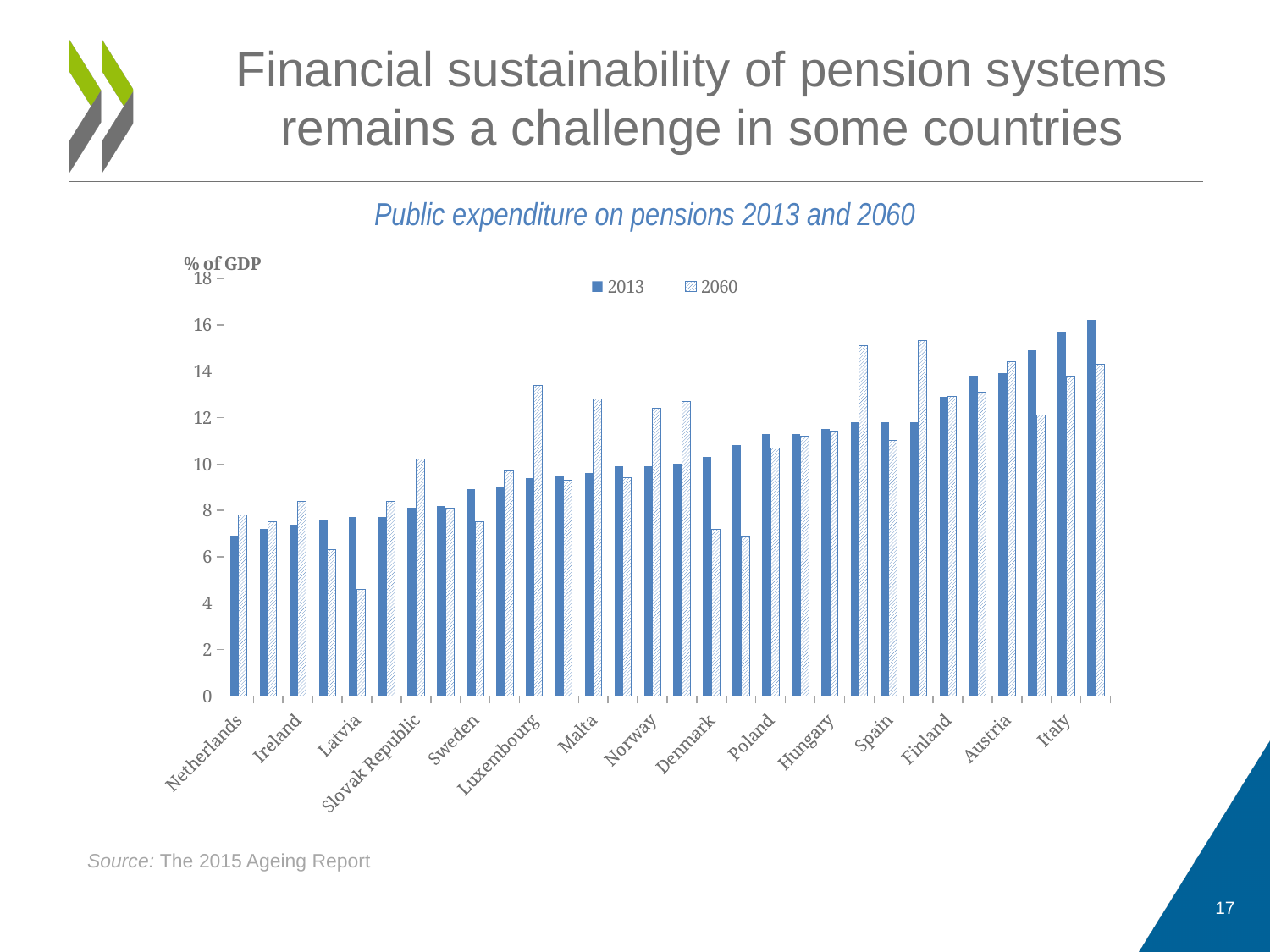
What unit is shown on the vertical axis label? % of GDP Is the 2060 value for the Netherlands greater or less than 6? greater Is the 2013 value for the Netherlands greater or less than 8? less For Italy, which is larger: the 2013 value or the 2060 value? 2013 For Luxembourg, which is larger: the 2013 value or the 2060 value? 2060 Is the 2060 value for Luxembourg greater or less than 12? greater For the Netherlands, which is larger: the 2013 value or the 2060 value? 2060 How many series does the legend list? 2 Do the 2013 values rise or fall moving from left to right along the x axis? Rise What are the two series shown in the legend? 2013 and 2060 What kind of chart is shown on the slide? Bar chart